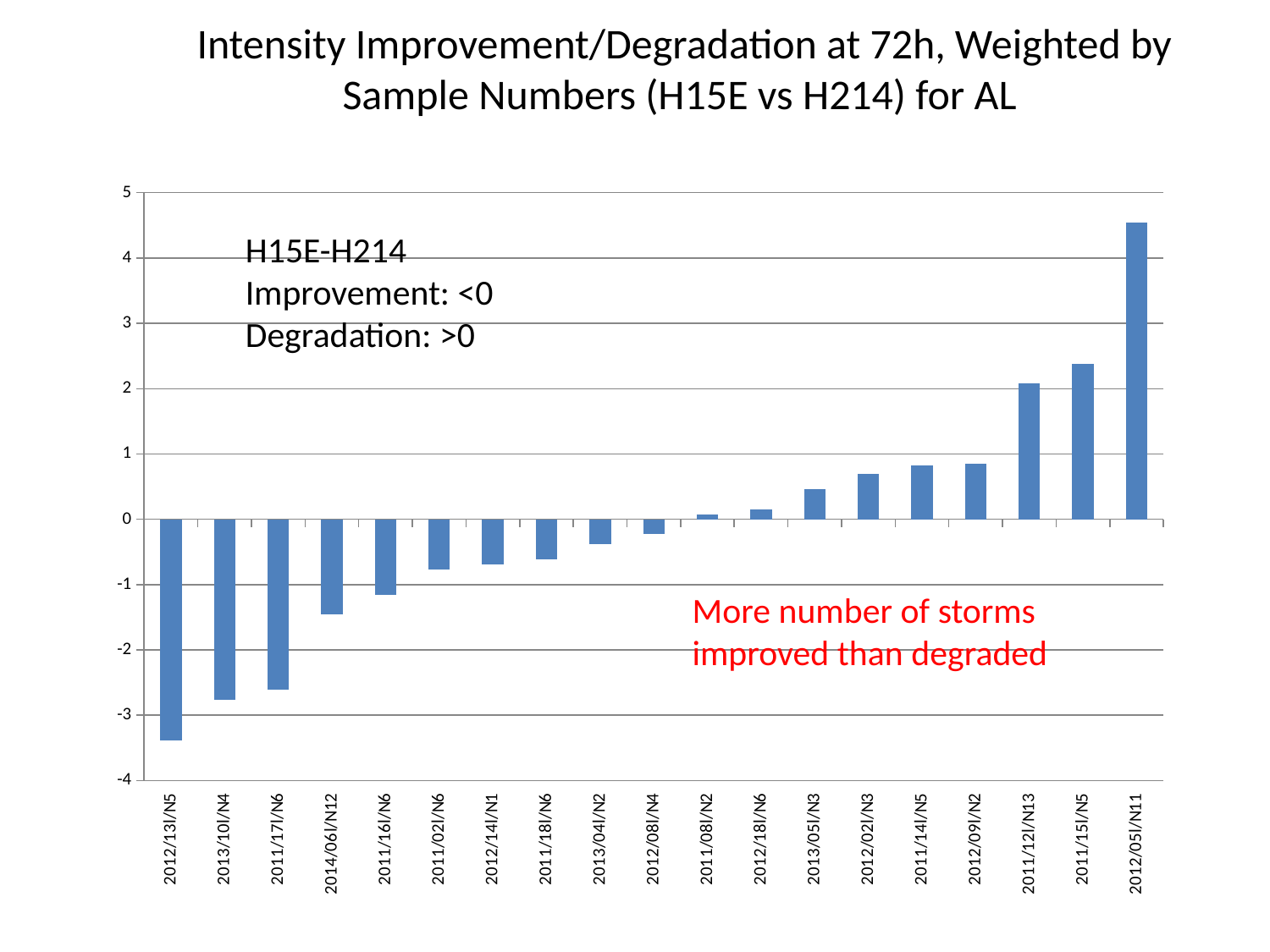
How many storm categories are plotted along the x axis? 19 Is the value for 2012/13l/N5 greater or less than -3? less Which has the larger value, 2011/15l/N5 or 2011/12l/N13? 2011/15l/N5 Which category has the highest value? 2012/05l/N11 Is the value for 2014/06l/N12 greater or less than -1? less According to the text on the chart, does a value below 0 indicate improvement or degradation? Improvement How many bars have values below zero? 10 What kind of chart is shown on the slide? bar chart Is the value for 2012/05l/N11 greater or less than 4? greater Do the bar values rise or fall moving from left to right along the x axis? rise Which category has the lowest value? 2012/13l/N5